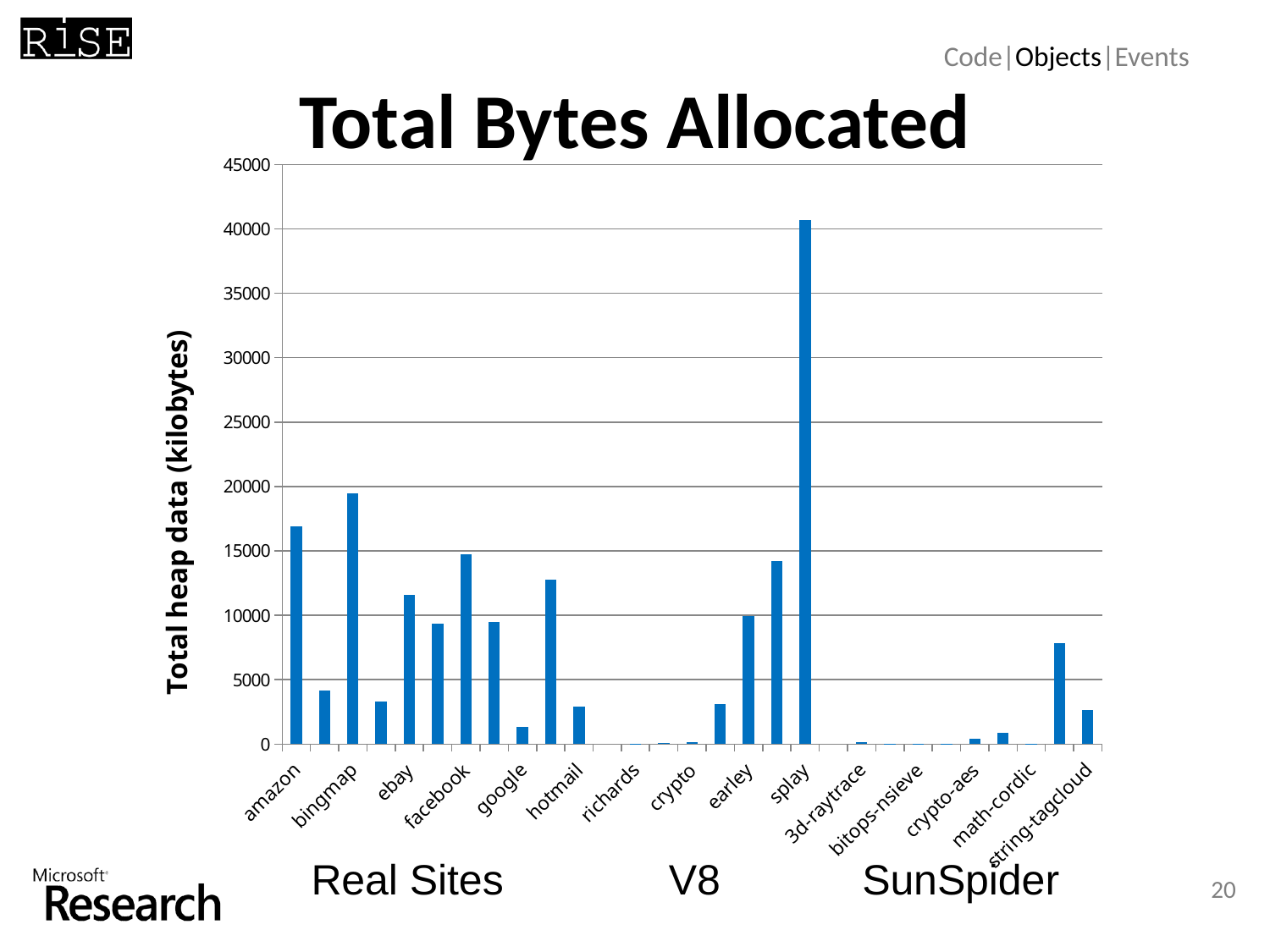
Is the value for ebay greater or less than 10000? greater What type of chart is shown on the slide? bar chart Is the value for google greater or less than 5000? less What is the title of the chart? Total Bytes Allocated Which has a larger value, facebook or google? facebook Is the value for bingmap greater or less than 15000? greater Which has a larger value, amazon or ebay? amazon Which has a larger value, earley or hotmail? earley What is the label on the vertical axis of the chart? Total heap data (kilobytes) Which category has the highest total heap data? splay